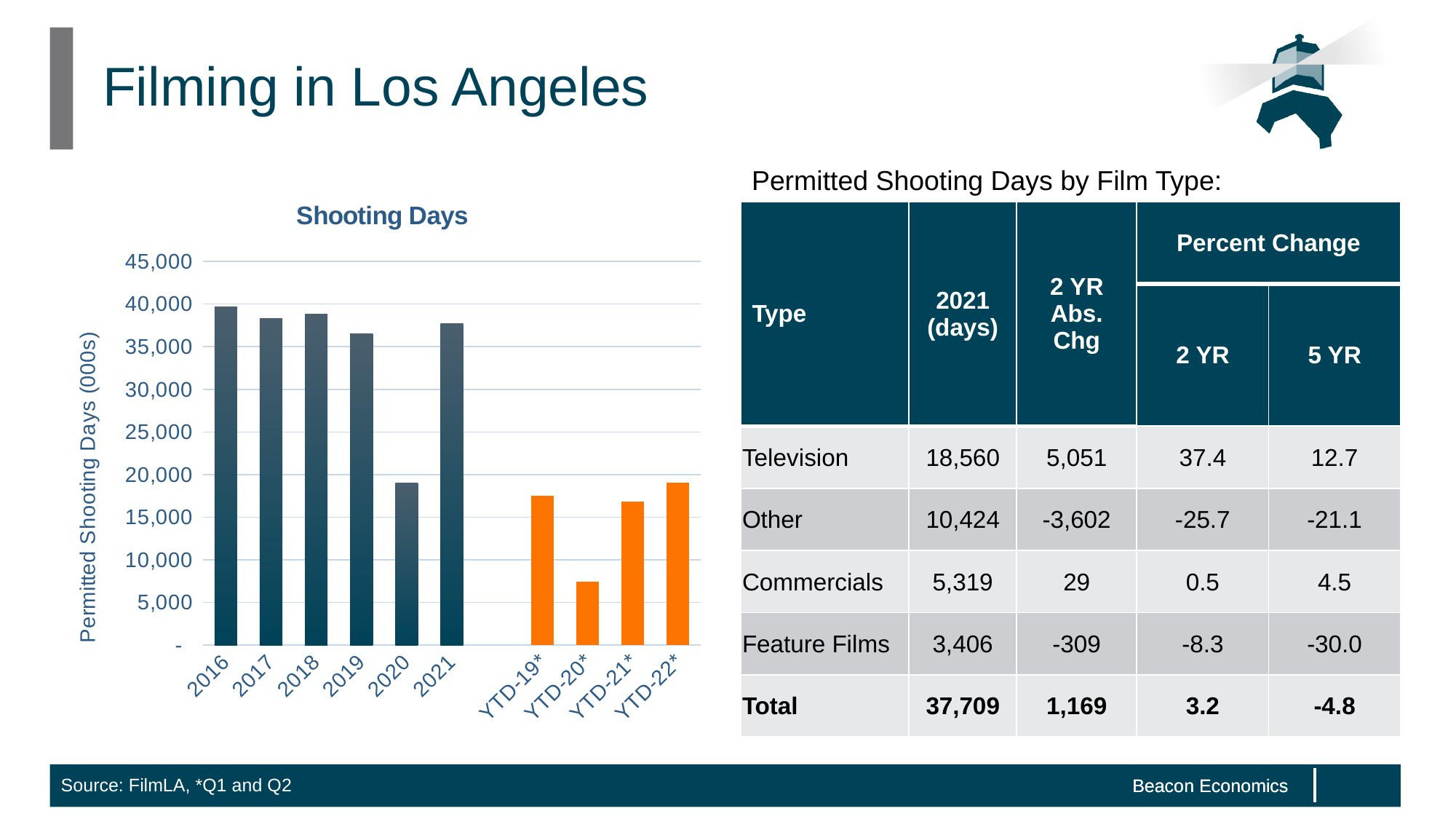
In the "Shooting Days" chart, what colour are the YTD bars? orange In the "Shooting Days" chart, do the values rise or fall from 2019 to 2020? fall In the "Shooting Days" chart, is the value for 2016 greater or less than 35,000? greater Which category has the lowest bar in the "Shooting Days" chart? YTD-20* In the "Shooting Days" chart, is the value for 2020 greater or less than 20,000? less In the "Shooting Days" chart, is the value for YTD-20* greater or less than 10,000? less How many bars are plotted in the "Shooting Days" chart? 10 What kind of chart is the "Shooting Days" chart? bar chart What is the y-axis label of the "Shooting Days" chart? Permitted Shooting Days (000s) In the "Shooting Days" chart, which is larger, the value for 2019 or the value for 2020? 2019 In the "Shooting Days" chart, which is larger, the value for YTD-22* or the value for YTD-20*? YTD-22*